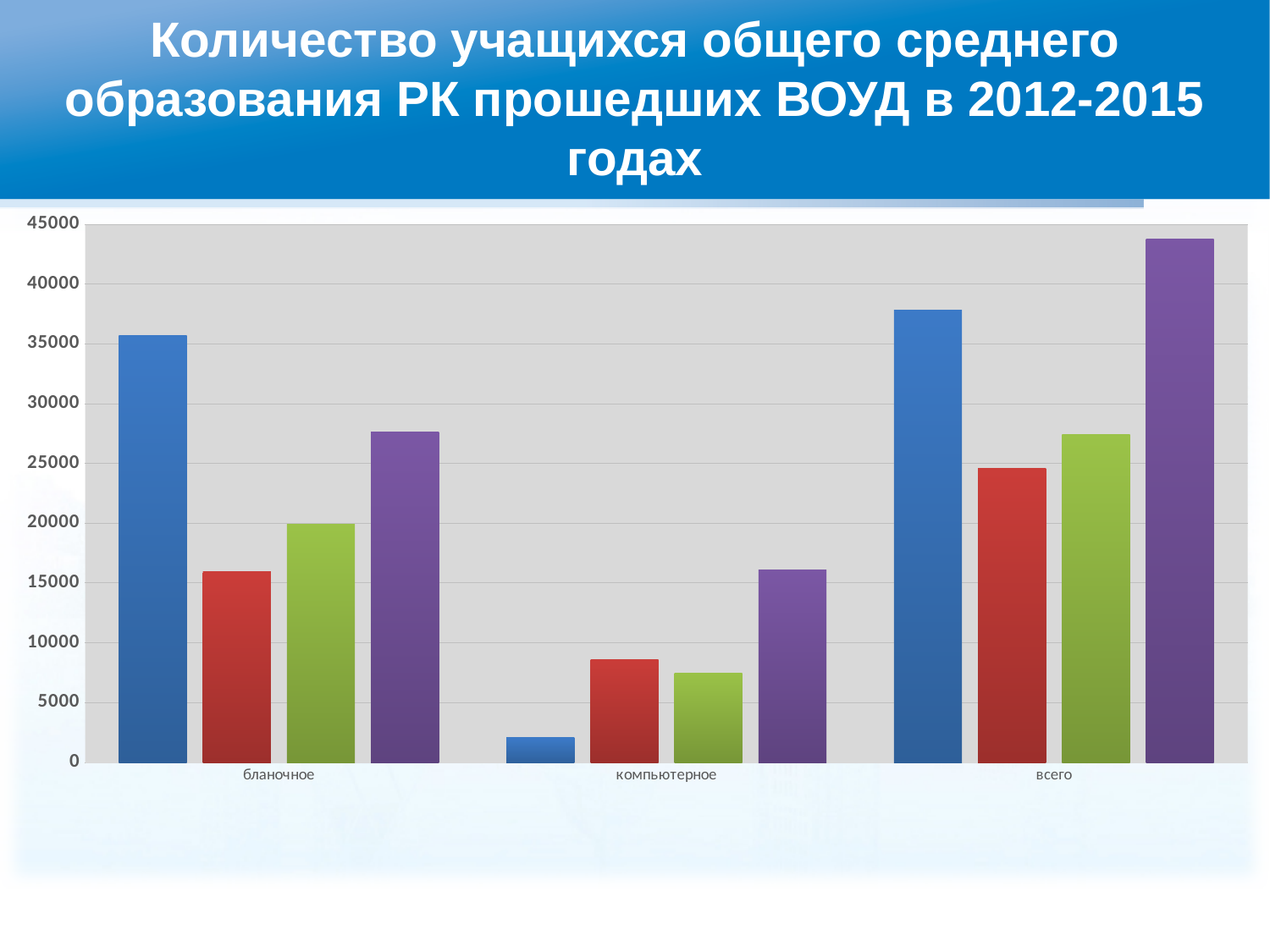
Is the value of the red bar for компьютерное greater or less than 10000? less Is the value of the purple bar for бланочное greater or less than 25000? greater What kind of chart is shown on the slide? bar chart Is the value of the blue bar for бланочное greater or less than 30000? greater What is the title of the chart on the slide? Количество учащихся общего среднего образования РК прошедших ВОУД в 2012-2015 годах How many bars are plotted for each category in the chart? 4 How many categories are shown on the x axis of the chart? 3 Which category has the tallest bar overall in the chart? всего Which category contains the shortest bar in the chart? компьютерное For the category всего, which is larger: the blue bar or the purple bar? the purple bar